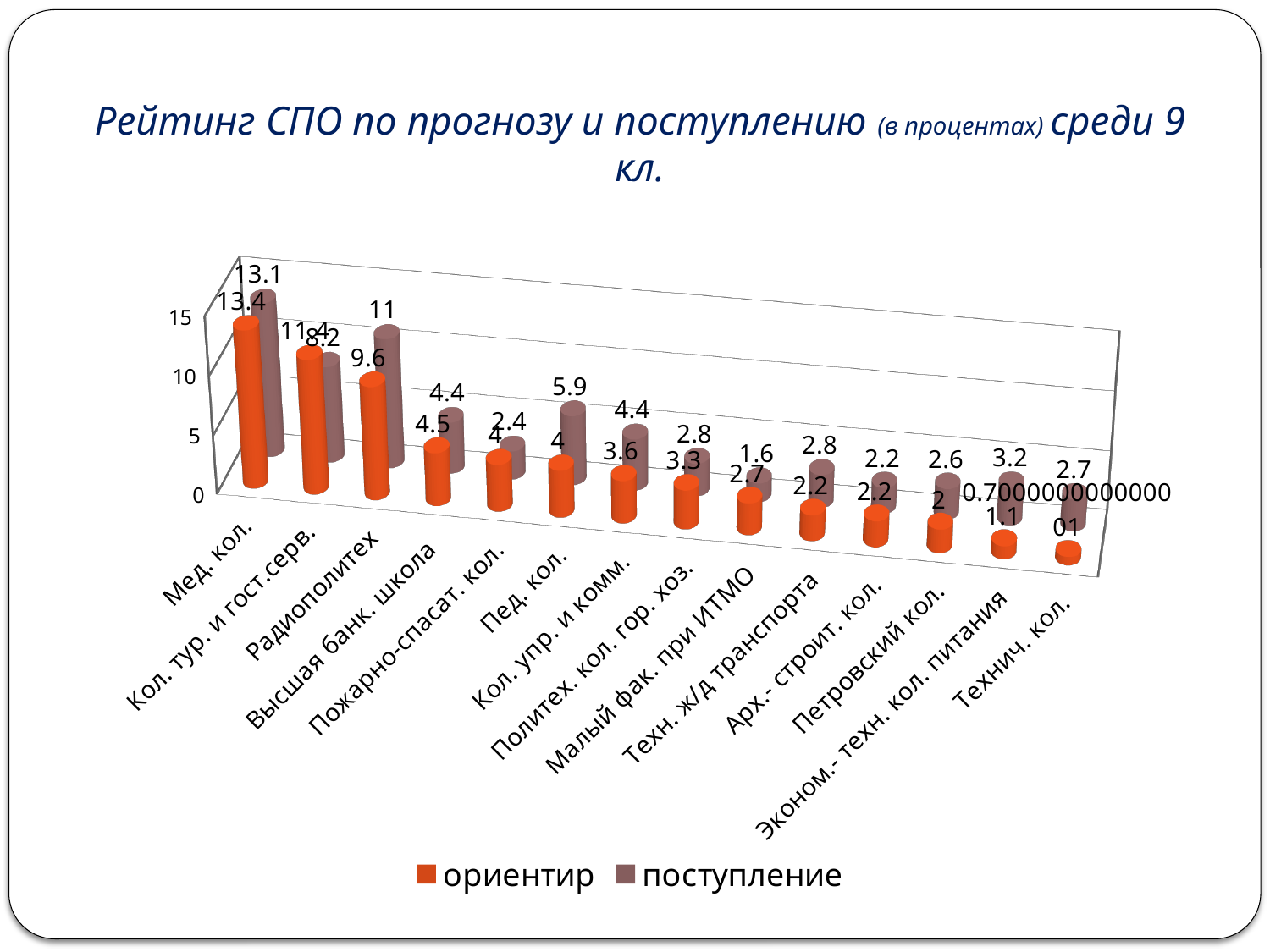
How many series does the legend list? 2 What kind of chart is shown on the slide? bar chart How many categories (institutions) are shown on the x axis? 14 What is the ориентир value for Мед. кол.? 13.4 For Радиополитех, what is the difference between the поступление and ориентир values? 1.4 What is the поступление value for Радиополитех? 11 What is the поступление value for Пед. кол.? 5.9 What is the ориентир value for Высшая банк. школа? 4.5 Which category has the highest поступление value? Мед. кол. For Пожарно-спасат. кол., which is larger: ориентир or поступление? ориентир What are the two series named in the legend? ориентир and поступление Which category has the highest ориентир value? Мед. кол.